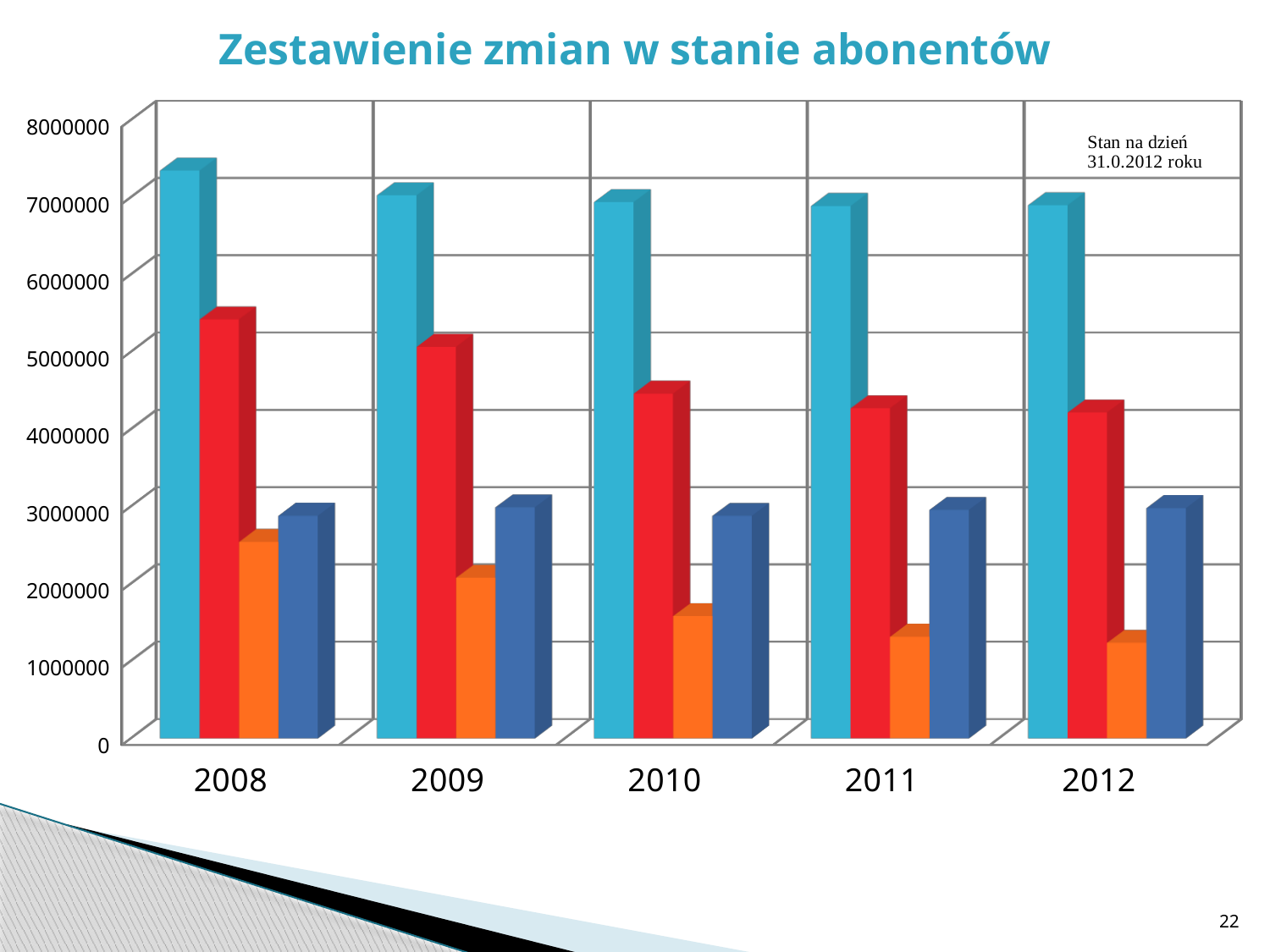
How many years are shown on the x axis of the chart? 5 In which year is the orange bar the lowest? 2012 Do the values of the red bars rise or fall from 2008 to 2012? fall Is the value of the orange bar for 2008 greater or less than 2000000? greater Is the value of the light blue bar for 2008 greater or less than 7000000? greater Is the value of the red bar for 2008 greater or less than 5000000? greater In which year is the light blue bar the highest? 2008 What is the title of the chart? Zestawienie zmian w stanie abonentów What type of chart is shown on the slide? bar chart In 2010, which is larger: the light blue bar or the red bar? the light blue bar